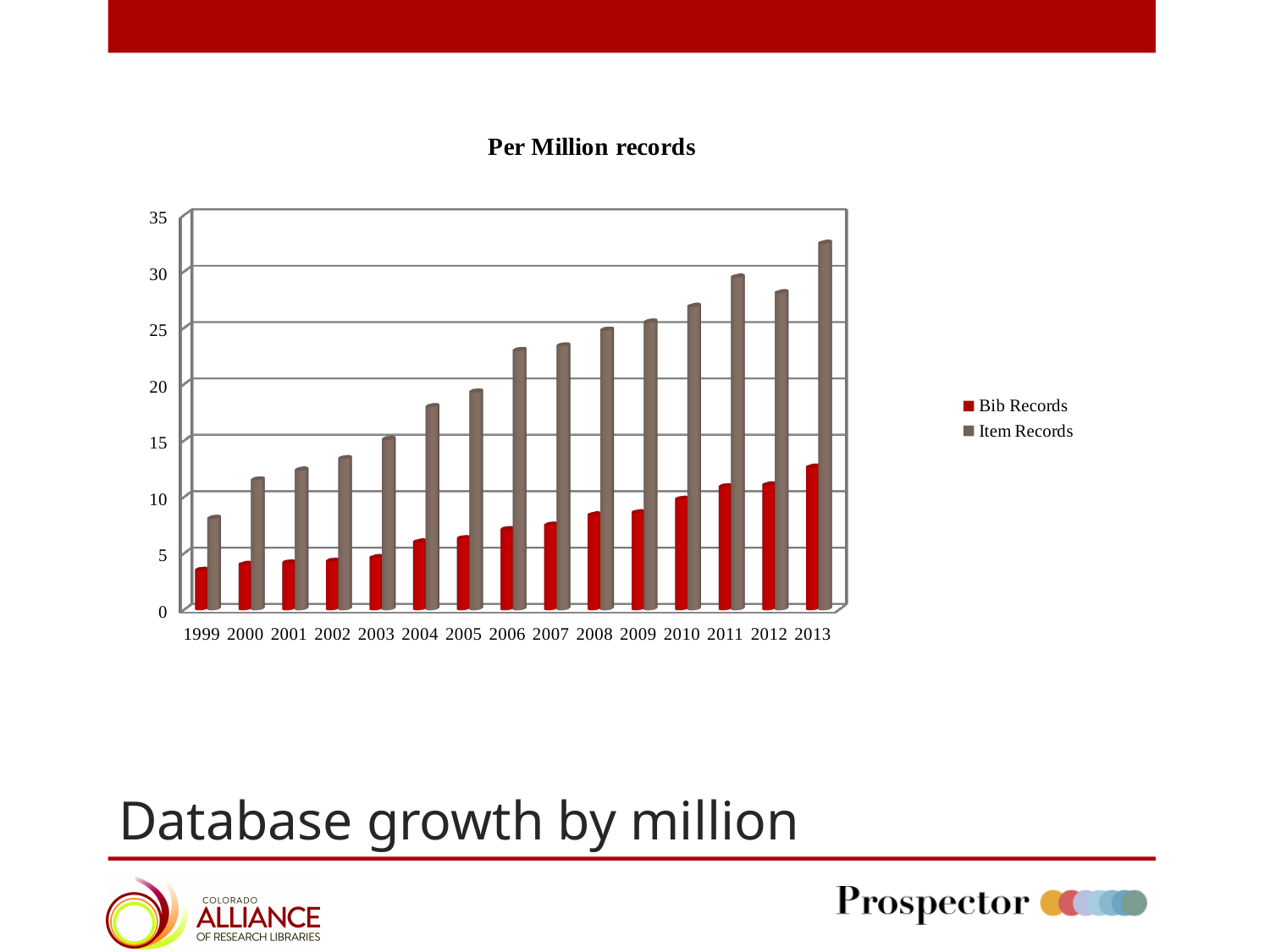
How many series does the legend list? 2 Which series is shown in red? Bib Records Do the Bib Records values generally rise or fall from 1999 to 2013? rise Is the Item Records value for 1999 greater or less than 10? less In which year is the Item Records value highest? 2013 Which year has the larger Item Records value, 2011 or 2012? 2011 Is the Bib Records value for 1999 greater or less than 5? less What is the title of the chart? Per Million records Is the Item Records value for 2013 greater or less than 30? greater How many years are shown on the x axis? 15 What kind of chart is shown on the slide? bar chart In which year is the Item Records value lowest? 1999